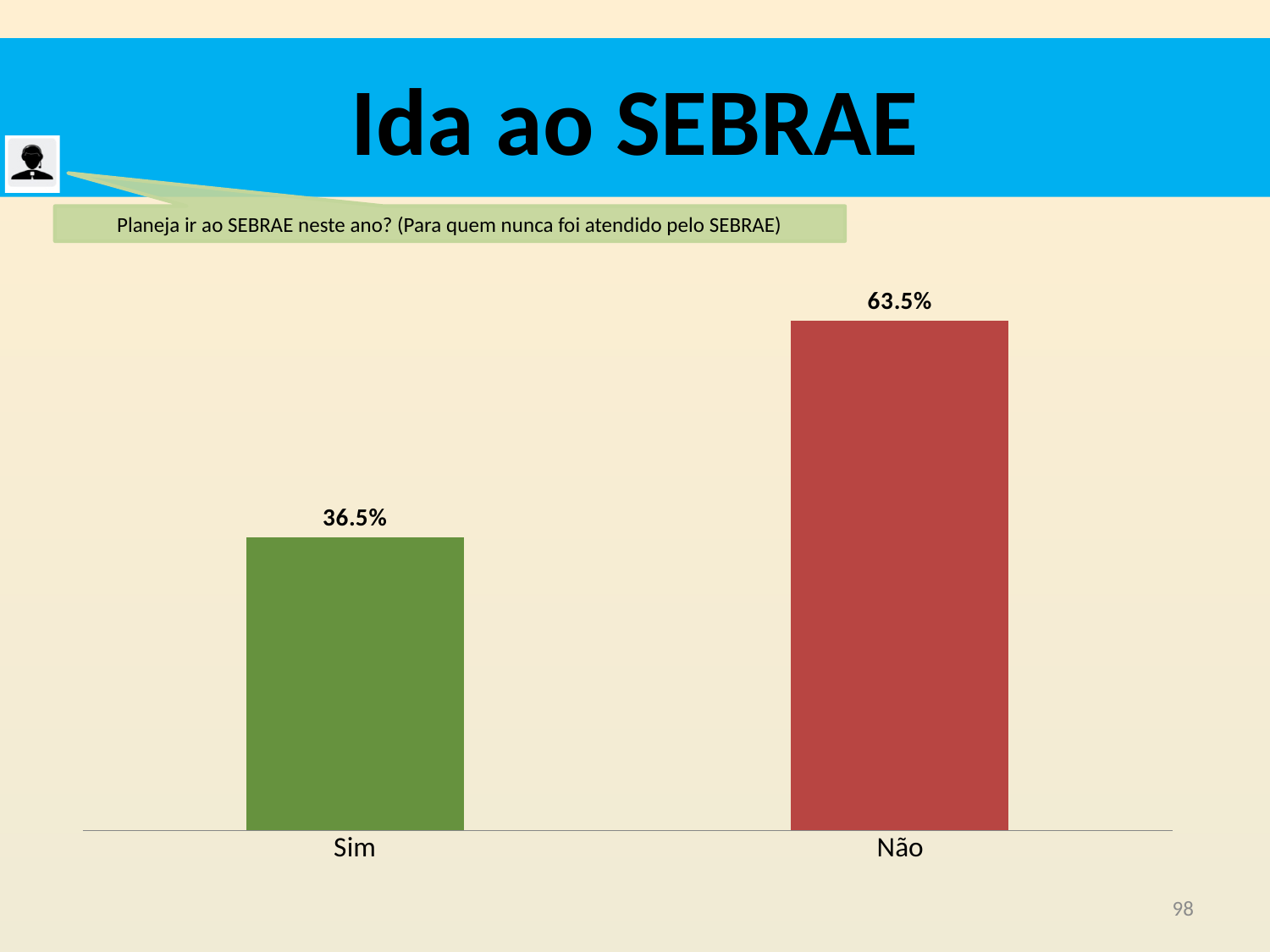
Which category has the lowest value? Sim What is the total of the values for Sim and Não? 100.0% How many categories are shown in the chart? 2 What kind of chart is shown on the slide? bar chart Which category has the highest value? Não What colour is the bar for Não? red What is the title of the slide? Ida ao SEBRAE What is the difference between the values for Não and Sim? 27.0% Which is larger, the value for Sim or the value for Não? Não What is the value for Não? 63.5% What is the value for Sim? 36.5%